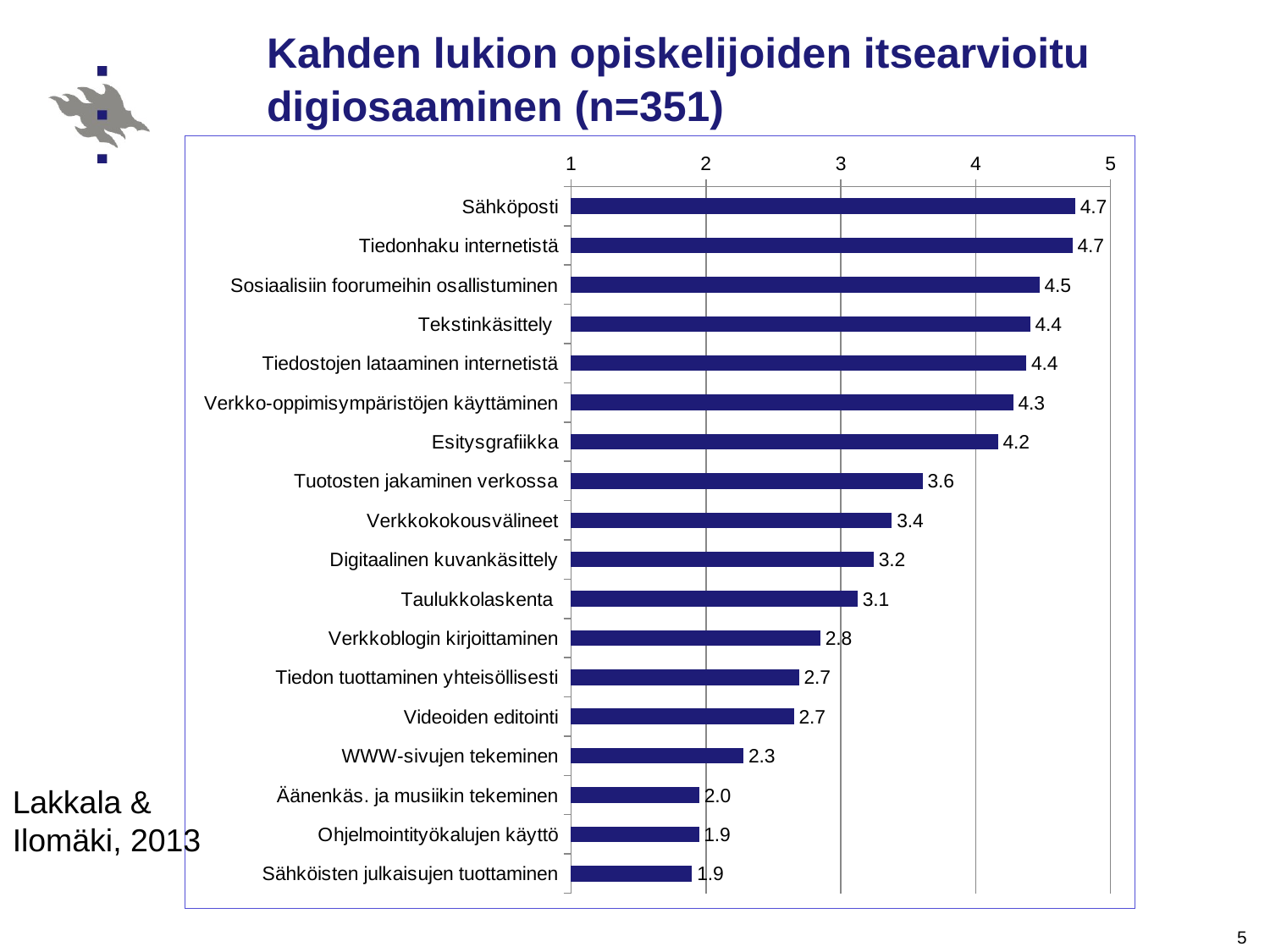
How many categories are shown in the chart? 18 What is the value for Esitysgrafiikka? 4.2 What is the lowest value shown in the chart? 1.9 What is the title of the chart on the slide? Kahden lukion opiskelijoiden itsearvioitu digiosaaminen (n=351) What is the value for Taulukkolaskenta? 3.1 What is the difference between the values for Sähköposti and Sähköisten julkaisujen tuottaminen? 2.8 What is the highest value shown in the chart? 4.7 What kind of chart is shown on the slide? Bar chart What is the value for Tekstinkäsittely? 4.4 What is the value for WWW-sivujen tekeminen? 2.3 Which has a larger value, Digitaalinen kuvankäsittely or Verkkoblogin kirjoittaminen? Digitaalinen kuvankäsittely What is the difference between the values for Tuotosten jakaminen verkossa and Verkkokokousvälineet? 0.2